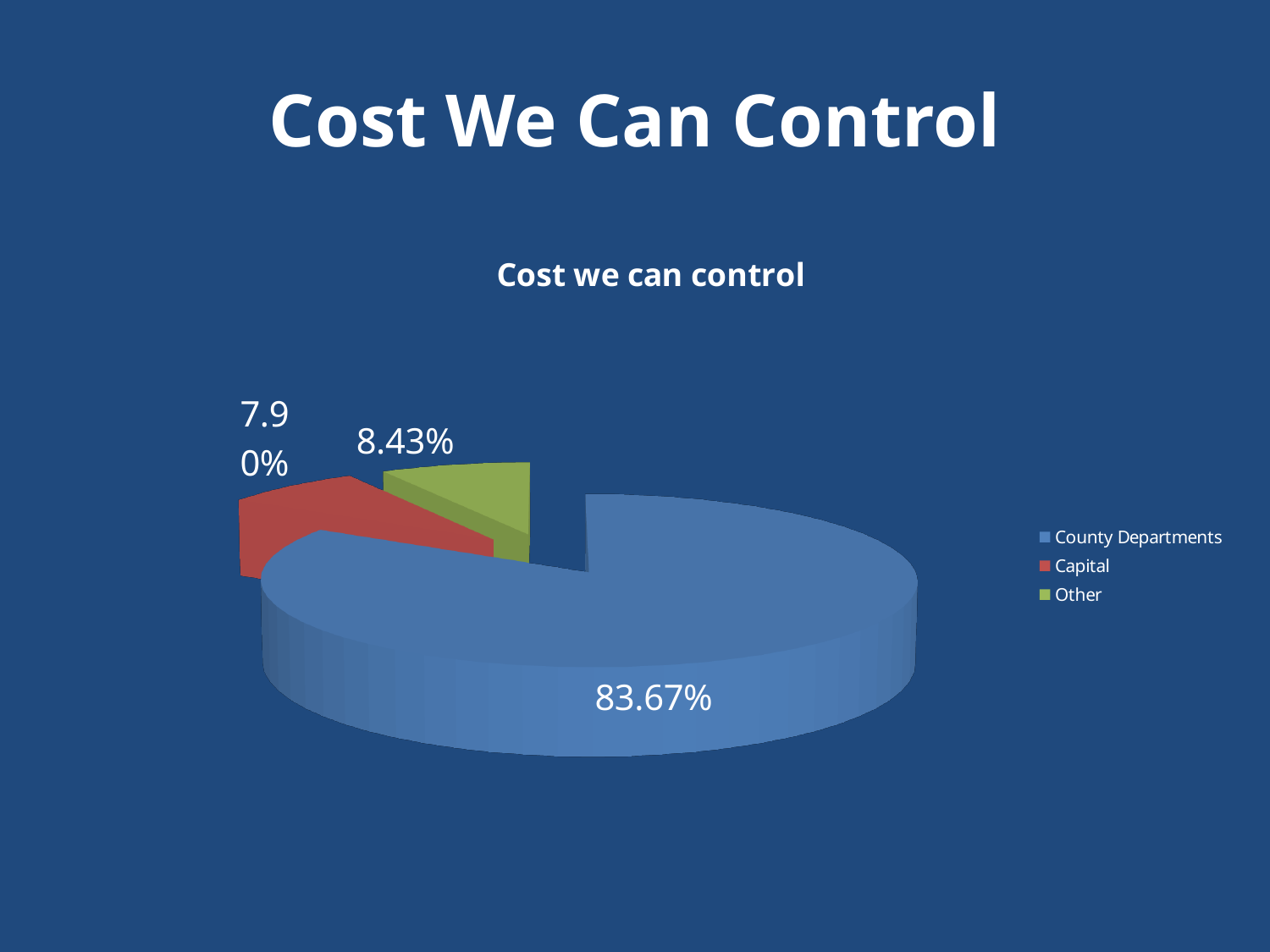
How many entries does the legend list? 3 What is the difference between the County Departments share and the Other share? 75.24% Which category has the largest slice of the pie? County Departments What is the title of the chart? Cost we can control What kind of chart is shown on the slide? pie chart How many slices does the pie chart have? 3 What share of the pie is Other? 8.43% Which colour represents Capital in the pie chart? red What share of the pie is County Departments? 83.67% Which is larger, the share for Other or the share for Capital? Other What share of the pie is Capital? 7.90% Which category has the smallest slice of the pie? Capital